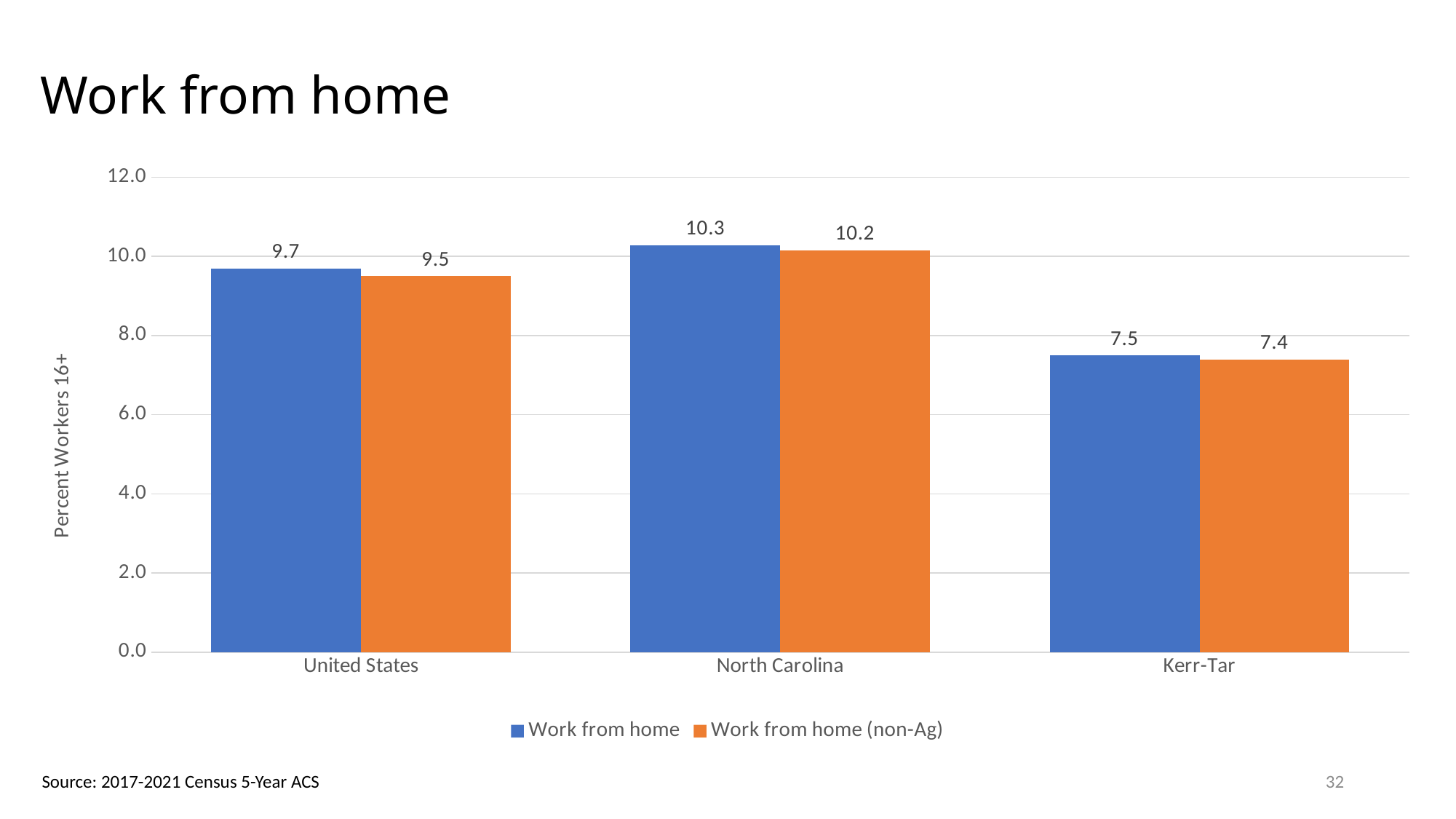
How many series does the legend list? 2 Which category has the highest Work from home value? North Carolina Which is larger: the Work from home (non-Ag) value for the United States or for Kerr-Tar? United States Which category has the lowest Work from home (non-Ag) value? Kerr-Tar What is the Work from home value for the United States? 9.7 What is the Work from home (non-Ag) value for Kerr-Tar? 7.4 What is the label of the y axis? Percent Workers 16+ How many categories are shown on the x axis? 3 What kind of chart is shown on the slide? bar chart Is the Work from home value for Kerr-Tar greater or less than 8.0? less What is the difference between the Work from home values for North Carolina and Kerr-Tar? 2.8 What is the Work from home value for North Carolina? 10.3